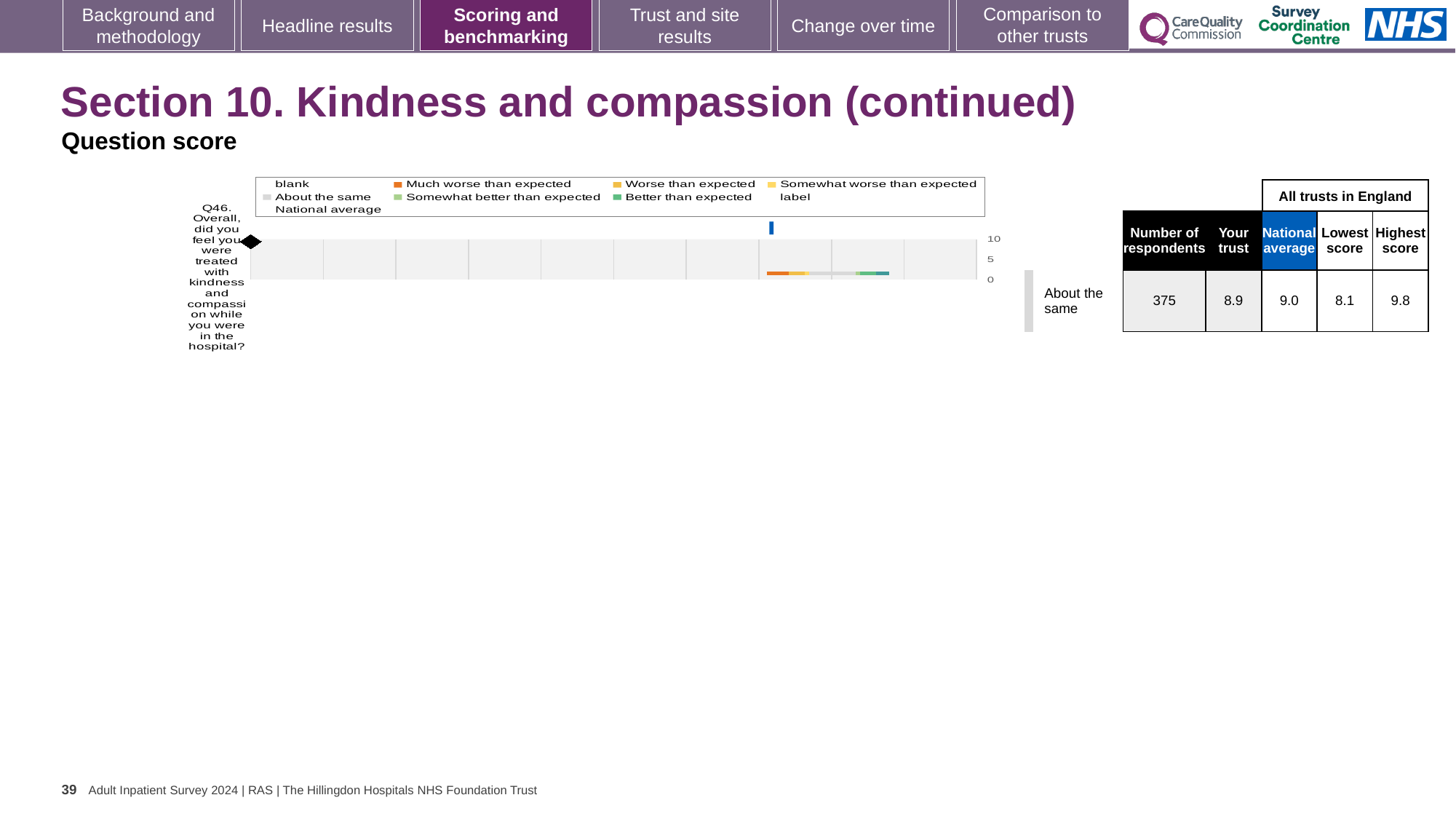
How many respondents answered Q46? 375 What is the lowest score among all trusts in England for Q46? 8.1 Which is larger for Q46, the 'Your trust' score or the national average? National average What kind of chart is shown on the slide? bar chart Is the 'Your trust' score for Q46 greater or less than 5 on the chart's axis? greater How many questions (categories) are plotted in the chart? 1 What is the 'Your trust' score for Q46? 8.9 What is the national average score for Q46? 9.0 What is the difference between the highest score and the lowest score for Q46? 1.7 Which benchmark category is the trust's result for Q46 placed in? About the same What is the highest value shown on the chart's axis? 10 What is the highest score among all trusts in England for Q46? 9.8